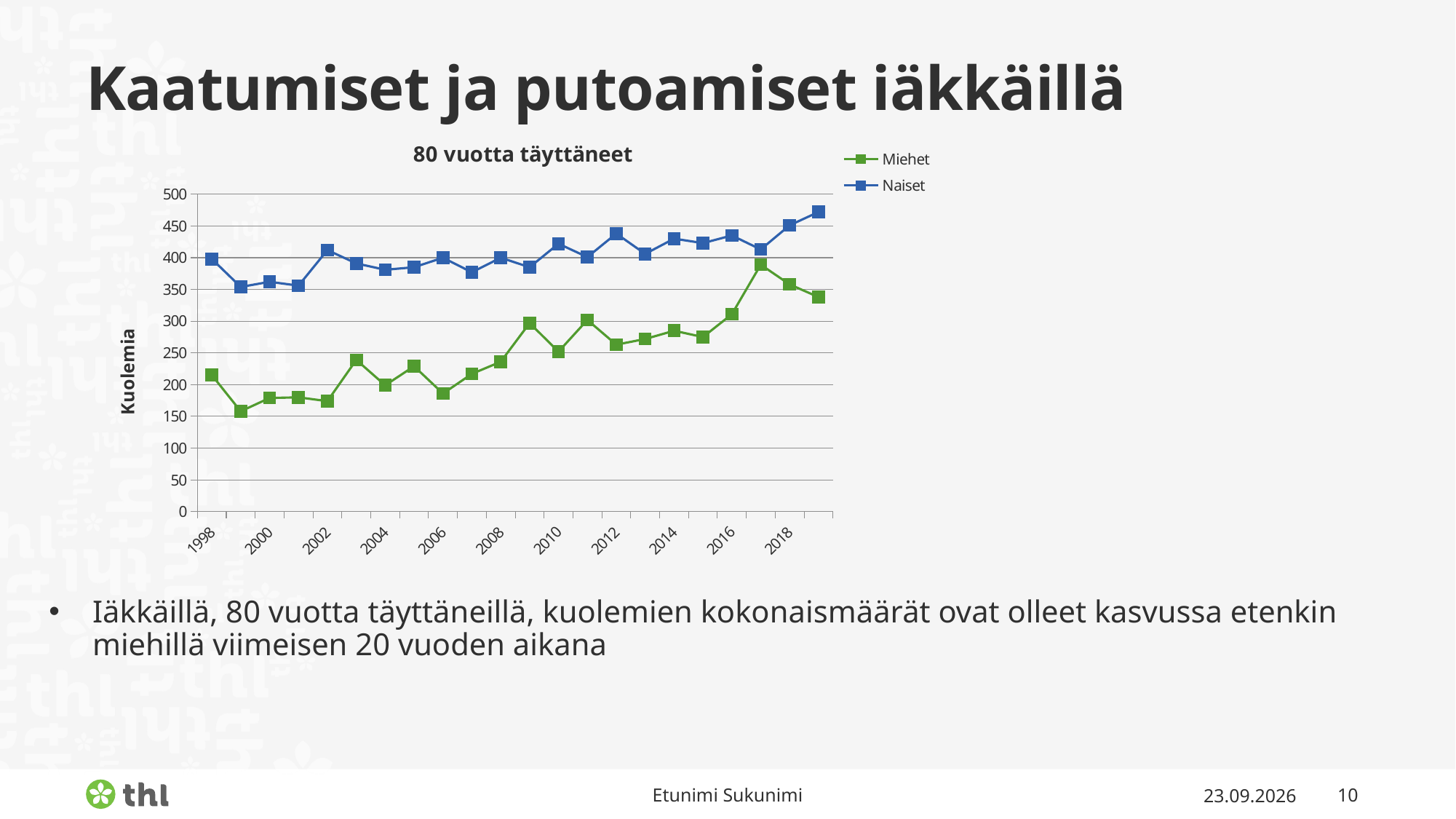
Which series has the higher value in 2010, Miehet or Naiset? Naiset Is the value for Naiset in 2012 greater or less than 400? greater How many yearly data points does each series have? 22 What is the title of the chart? 80 vuotta täyttäneet Overall, do the values for Miehet rise or fall from 1998 to 2019? rise Is the value for Naiset in 2019 greater or less than 450? greater How many series does the legend list? 2 Is the value for Miehet in 2006 greater or less than 200? less What are the two series named in the legend? Miehet and Naiset In which year does the Miehet series reach its highest value? 2017 What kind of chart is shown on the slide? line chart